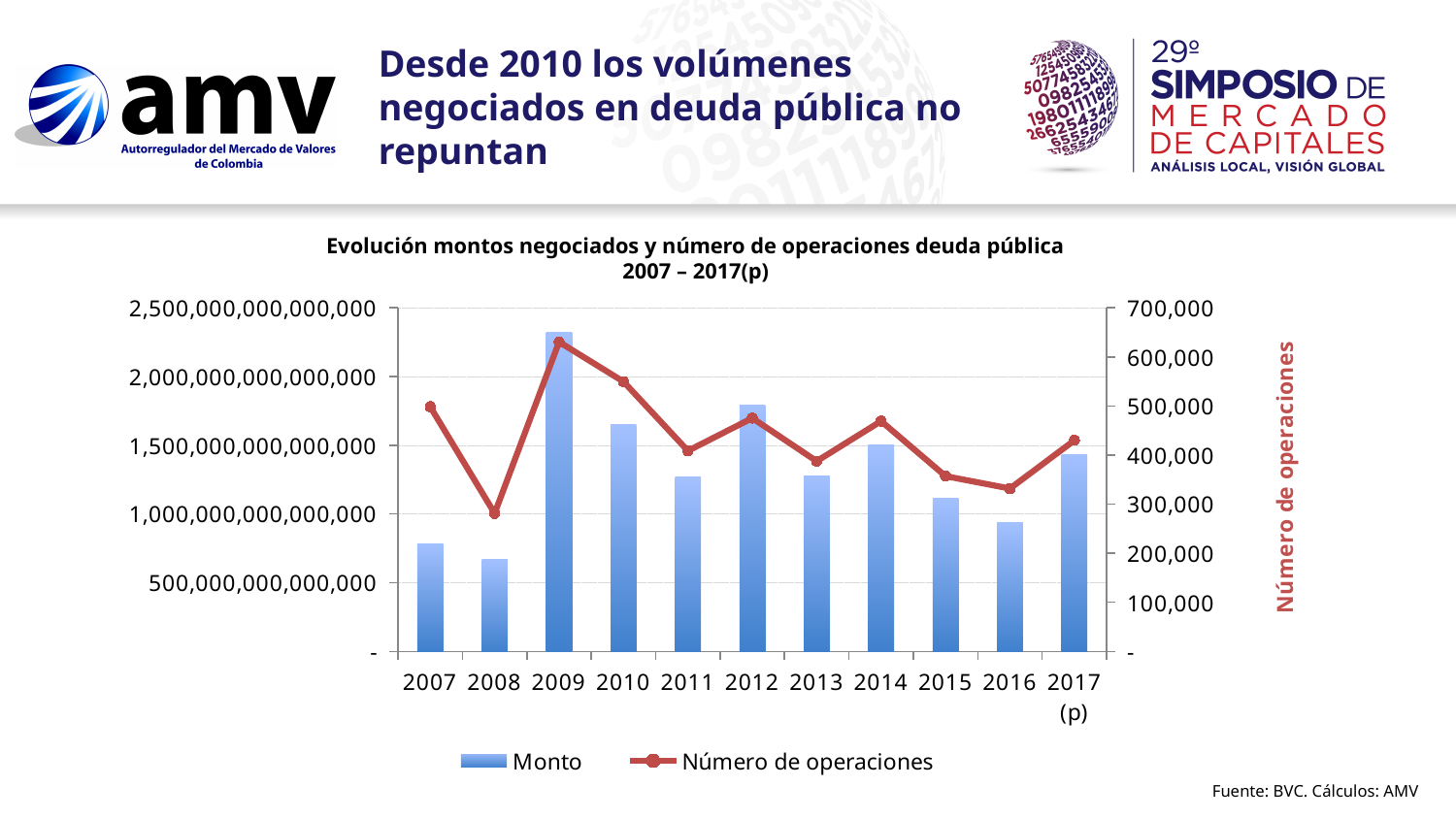
Is the Número de operaciones value for 2008 greater or less than 300,000? less Which year has the larger Monto bar, 2012 or 2010? 2012 Does the Monto bar rise or fall from 2014 to 2016? It falls How many years are shown on the x axis of the chart? 11 What kind of chart is shown on the slide? A combined bar and line chart In which year is the Monto bar highest? 2009 Is the Monto value for 2009 greater or less than 2,000,000,000,000,000? greater In which year is the Monto bar lowest? 2008 In which year does the Número de operaciones line reach its highest point? 2009 In which year does the Número de operaciones line reach its lowest point? 2008 How many series does the chart legend list? 2 What is the title of the chart? Evolución montos negociados y número de operaciones deuda pública 2007 – 2017(p)